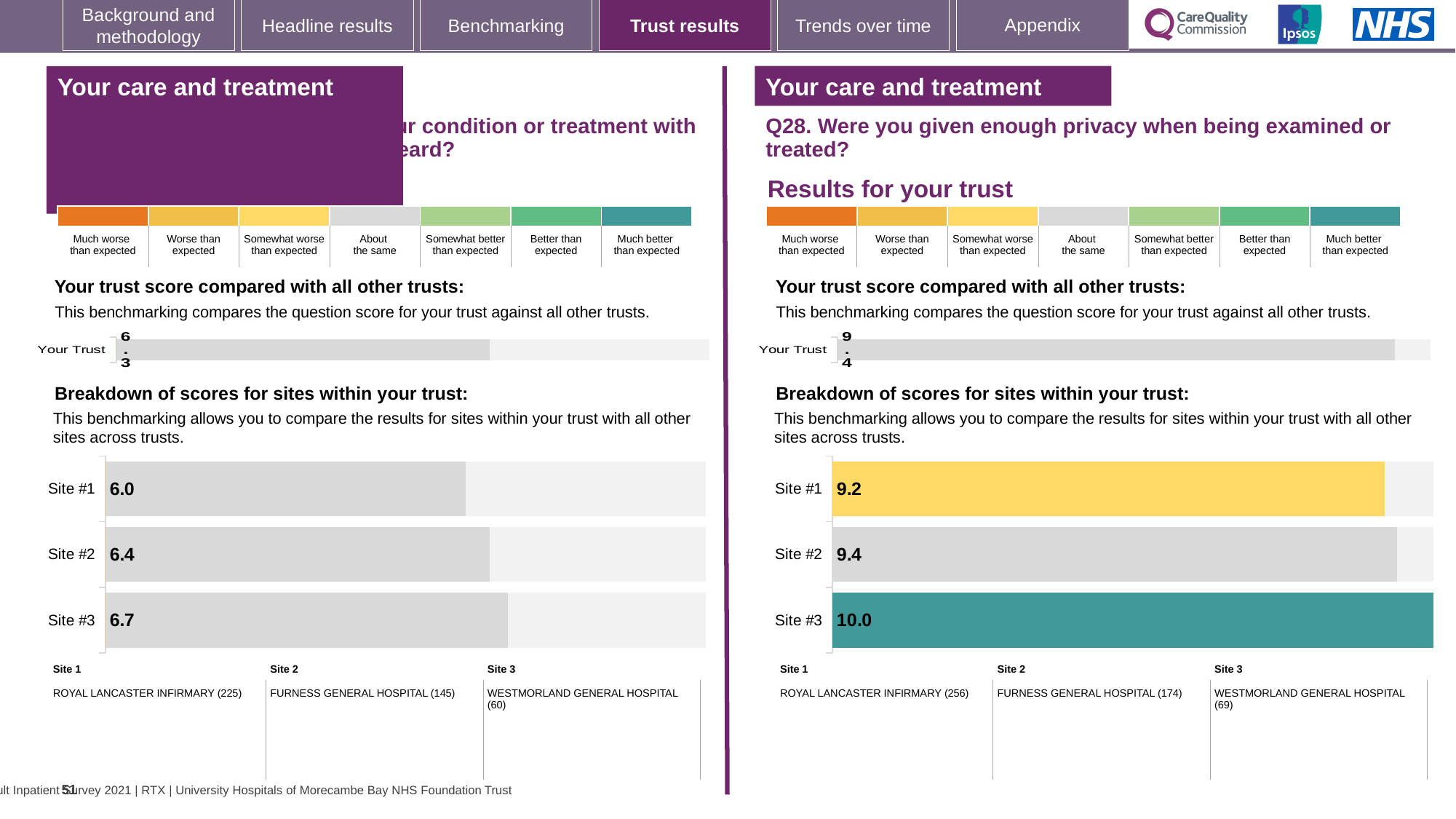
How many sites are shown in the left-hand 'Breakdown of scores for sites within your trust' chart? 3 In the left-hand 'Breakdown of scores for sites within your trust' chart, what is the difference between the scores for Site #3 and Site #1? 0.7 In the Q28 'Breakdown of scores for sites within your trust' chart, what is the score for Site #1? 9.2 In the left-hand 'Breakdown of scores for sites within your trust' chart, which site has the lowest score? Site #1 In the left-hand 'Breakdown of scores for sites within your trust' chart, what is the score for Site #2? 6.4 In the Q28 'Breakdown of scores for sites within your trust' chart, which has the larger score, Site #2 or Site #3? Site #3 What type of chart is the Q28 'Breakdown of scores for sites within your trust' chart? Bar chart In the Q28 'Your trust score compared with all other trusts' chart, what is the score for Your Trust? 9.4 In the Q28 'Breakdown of scores for sites within your trust' chart, what is the difference between the scores for Site #3 and Site #1? 0.8 In the Q28 'Breakdown of scores for sites within your trust' chart, what is the score for Site #3? 10.0 In the Q28 'Breakdown of scores for sites within your trust' chart, which site has the lowest score? Site #1 In the left-hand 'Breakdown of scores for sites within your trust' chart, which site has the highest score? Site #3